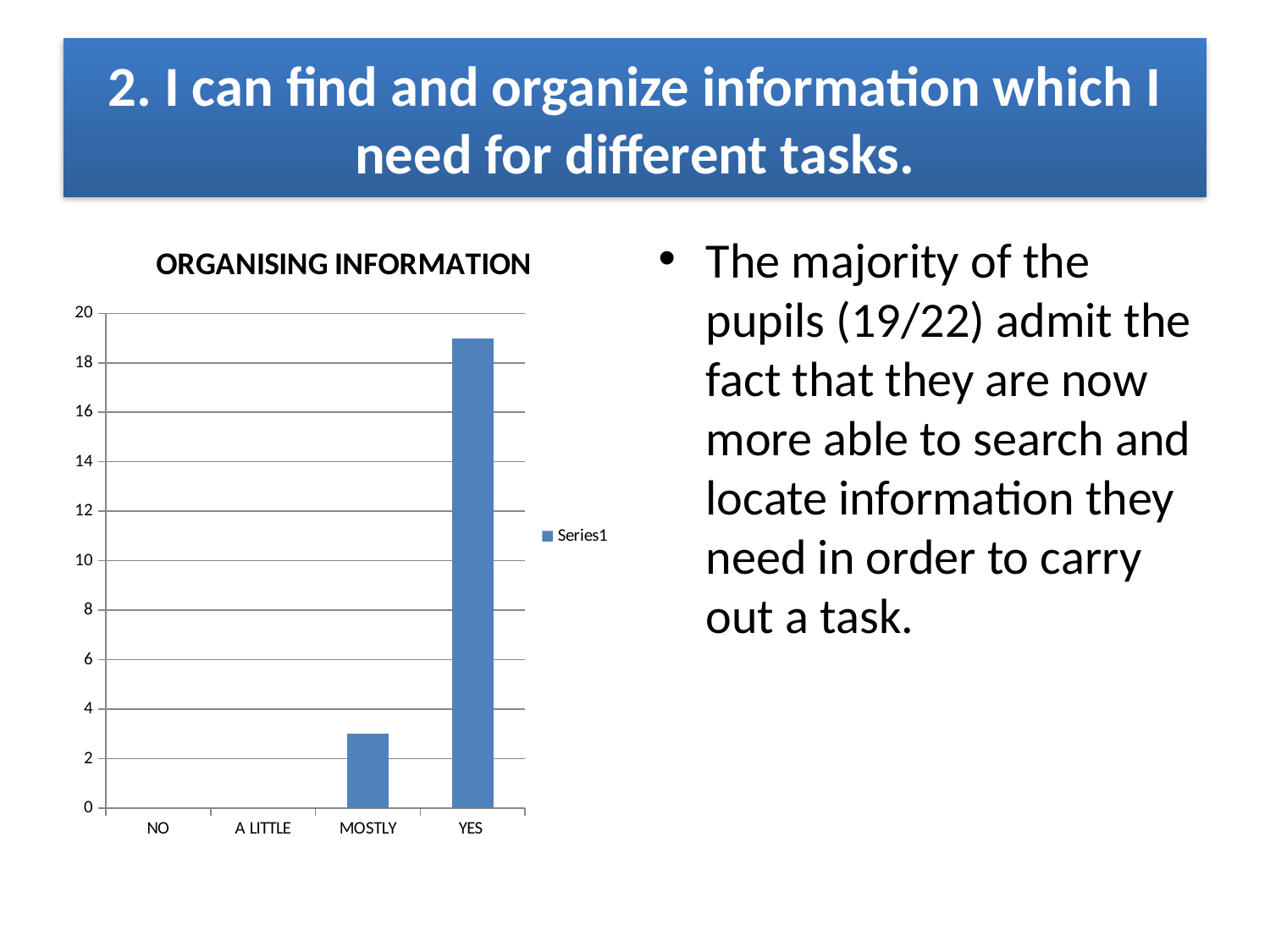
How many series does the legend of the ORGANISING INFORMATION chart list? 1 What is the highest value shown on the y axis of the ORGANISING INFORMATION chart? 20 Is the value for MOSTLY greater or less than 2? greater What is the title of the chart on the slide? ORGANISING INFORMATION Is the value for MOSTLY greater or less than 4? less What kind of chart is shown under the title ORGANISING INFORMATION? bar chart Which category has the highest value in the ORGANISING INFORMATION chart? YES Which is larger, the value for YES or the value for MOSTLY? YES How many categories are shown on the x axis of the ORGANISING INFORMATION chart? 4 Is the value for YES greater or less than 18? greater What is the name of the series shown in the legend? Series1 Do the values rise or fall moving from NO to YES along the x axis? rise